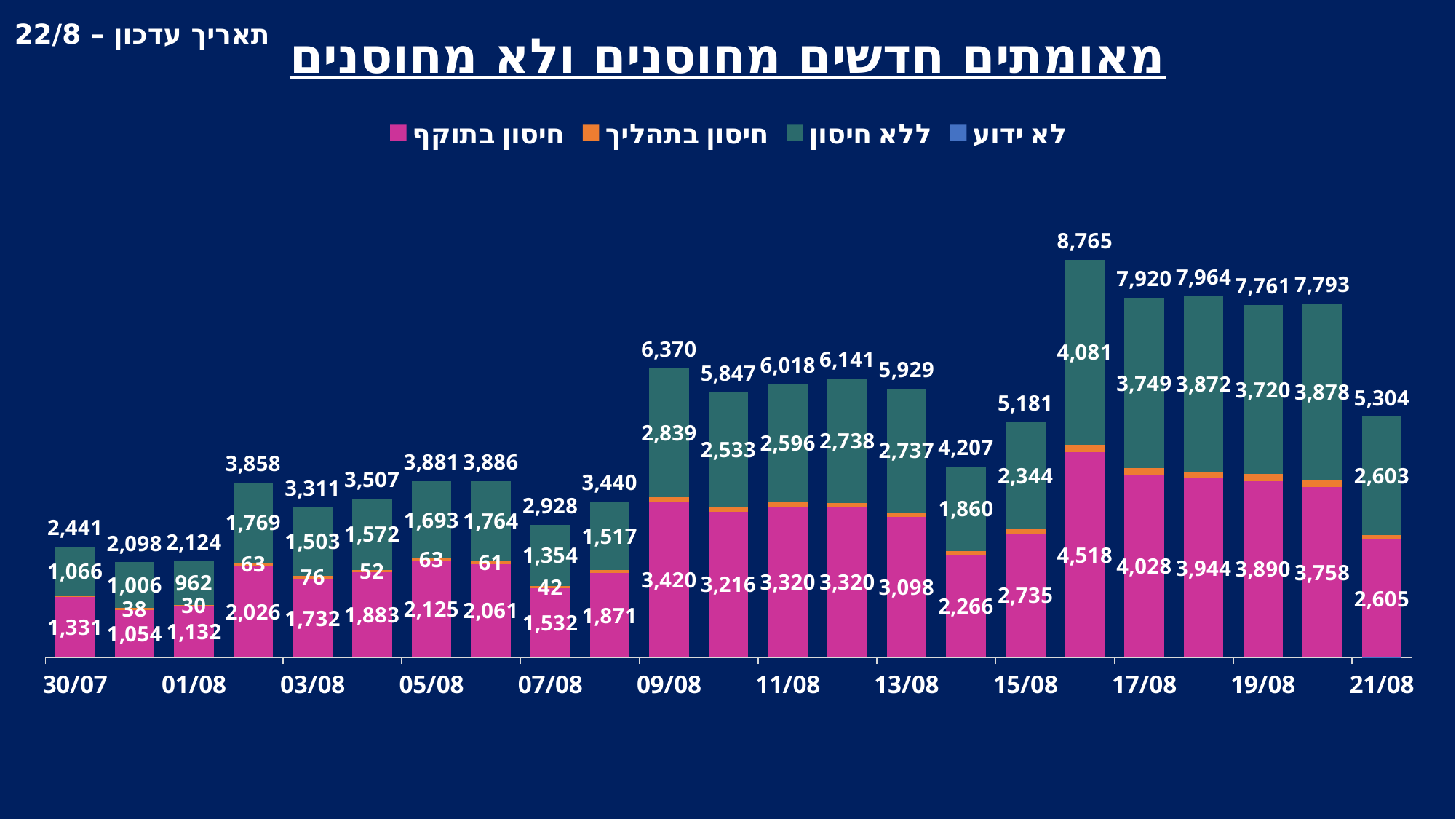
What is the value of the חיסון בתהליך (orange) segment for 03/08? 76 What is the value of the חיסון בתוקף (pink) segment for 09/08? 3,420 How many bars (dates) are plotted in the chart? 23 What is the highest bar total shown in the chart? 8,765 What is the difference between the bar totals for 09/08 and 07/08? 3,442 Which legend entry is shown in pink? חיסון בתוקף What is the value of the ללא חיסון (teal) segment for 17/08? 3,749 What type of chart is shown on the slide? stacked bar chart Which is larger for 19/08: the חיסון בתוקף (pink) segment or the ללא חיסון (teal) segment? חיסון בתוקף (3,890) What is the total value of the bar for 21/08? 5,304 How many series does the legend list? 4 What is the lowest bar total shown in the chart? 2,098